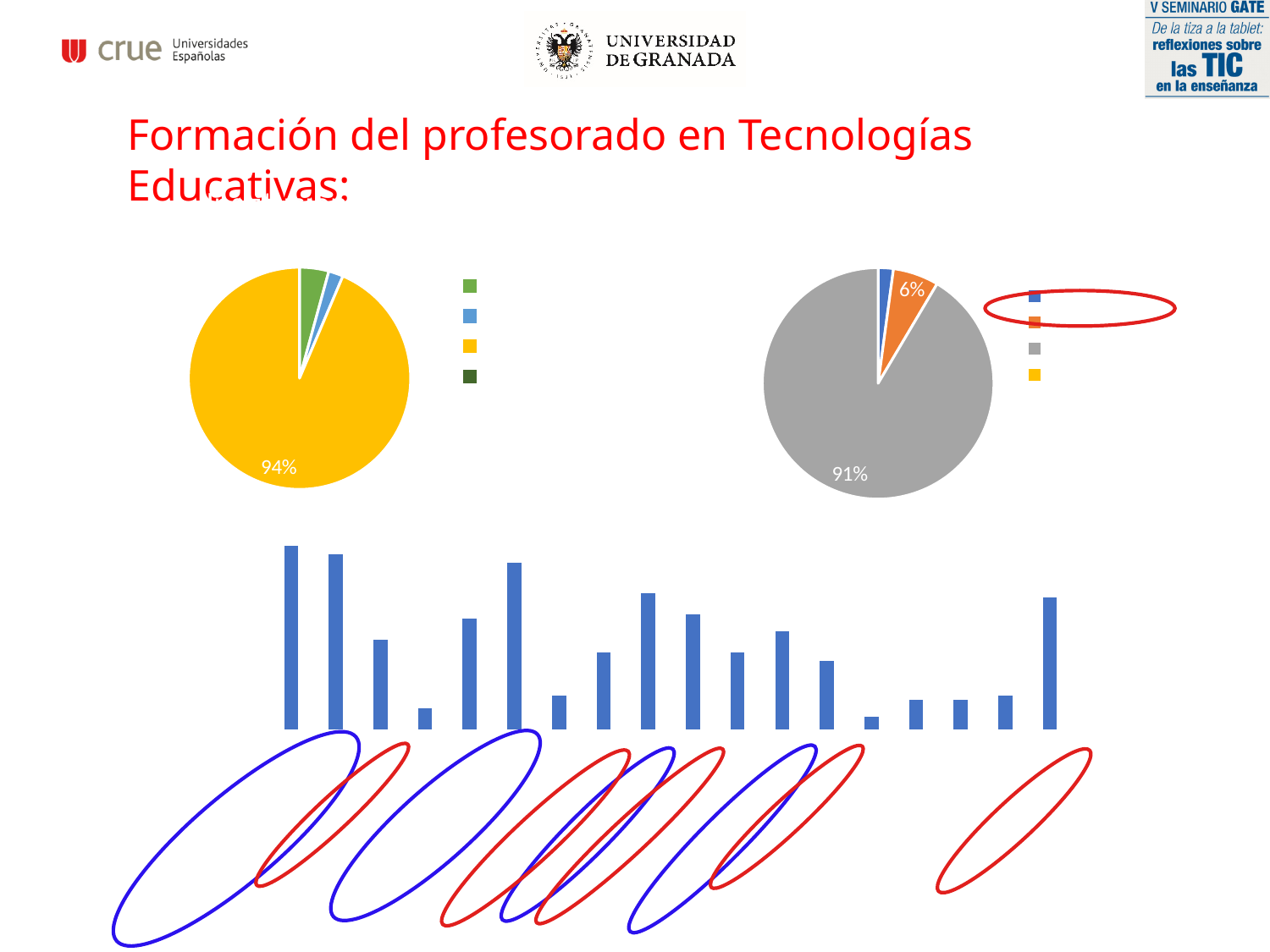
What colour are the bars in the bar chart at the bottom of the slide? blue In the right pie chart, what percentage is shown on the grey slice? 91% In the left pie chart, what colour is the largest slice? yellow How many entries does the legend of the left pie chart list? 4 In the right pie chart, what is the difference in percentage points between the grey slice and the orange slice? 85 What type of chart is the chart on the left of the slide? pie chart What type of chart is the chart at the bottom of the slide? bar chart In the right pie chart, what percentage is shown on the orange slice? 6% How many entries does the legend of the right pie chart list? 4 How many bars does the bar chart at the bottom of the slide have? 18 In the left pie chart, what percentage is shown on the largest slice? 94% In the right pie chart, which slice is larger, the grey one or the orange one? the grey one